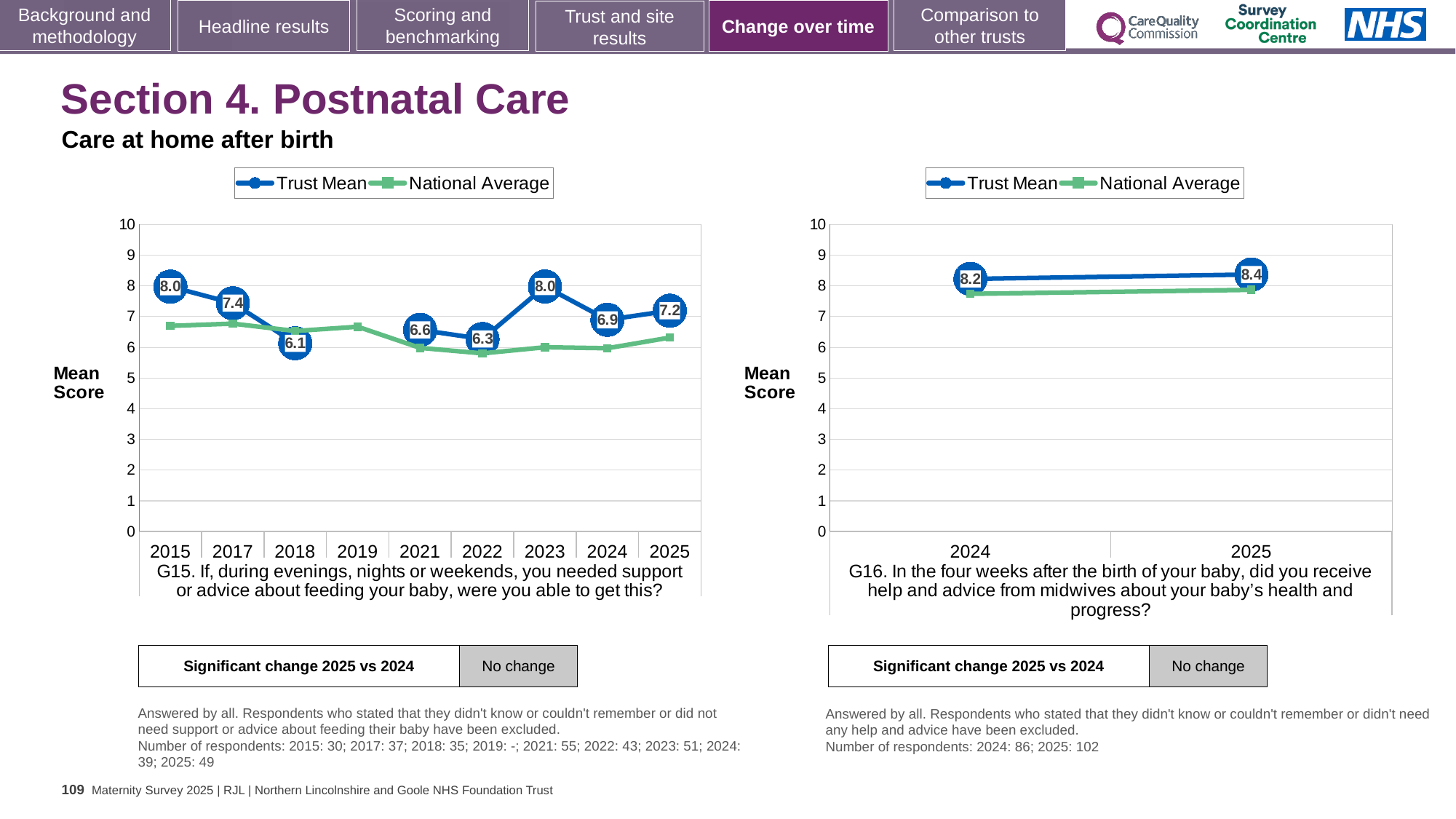
In the G15 chart on the left, what is the Trust Mean for 2018? 6.1 In the G16 chart on the right, what is the Trust Mean for 2024? 8.2 How many years are shown on the x axis of the G15 chart on the left? 9 In the G15 chart on the left, which year has the lowest Trust Mean? 2018 In the G15 chart on the left, what is the difference between the Trust Mean in 2023 and in 2024? 1.1 In the G15 chart on the left, what is the Trust Mean for 2025? 7.2 In the G15 chart on the left, is the Trust Mean higher in 2017 or in 2022? 2017 In the G15 chart on the left, is the National Average for 2022 greater or less than 7? less What type of chart is the G15 chart on the left? line chart In the G16 chart on the right, does the Trust Mean rise or fall from 2024 to 2025? rise How many series does the legend of the G16 chart on the right list? 2 In the G16 chart on the right, what is the difference between the Trust Mean in 2025 and in 2024? 0.2